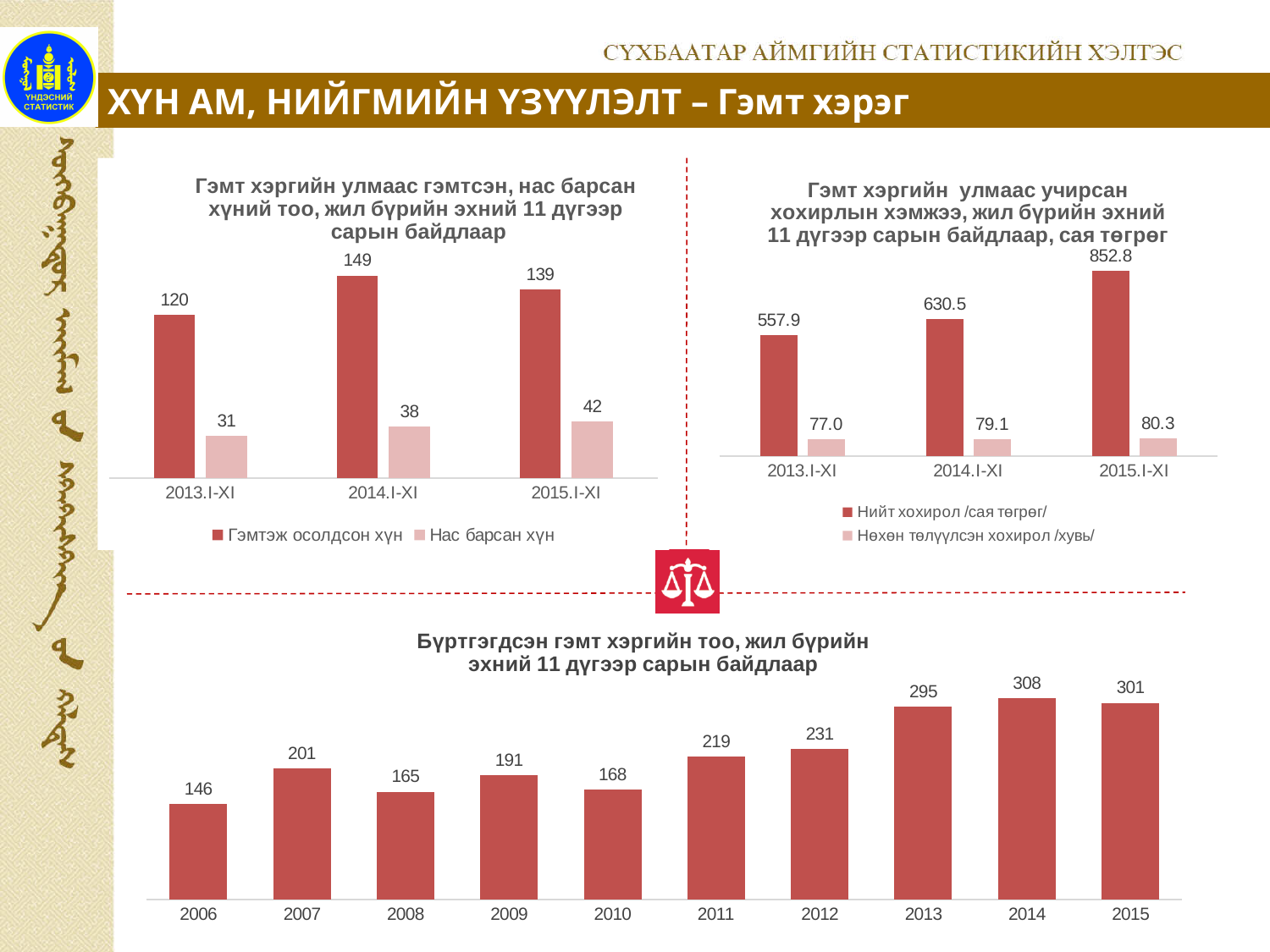
In the top-right chart (Гэмт хэргийн улмаас учирсан хохирлын хэмжээ), does the value for Нийт хохирол rise or fall from 2013.I-XI to 2015.I-XI? rise What kind of chart is the bottom chart (Бүртгэгдсэн гэмт хэргийн тоо)? bar chart In the bottom chart (Бүртгэгдсэн гэмт хэргийн тоо), what is the difference between the values for 2015 and 2006? 155 In the bottom chart (Бүртгэгдсэн гэмт хэргийн тоо), how many years are shown on the x axis? 10 In the top-left chart (Гэмт хэргийн улмаас гэмтсэн, нас барсан хүний тоо), how many series does the legend list? 2 In the bottom chart (Бүртгэгдсэн гэмт хэргийн тоо), which year has the highest value? 2014 In the bottom chart (Бүртгэгдсэн гэмт хэргийн тоо), which year has the lowest value? 2006 In the top-left chart (Гэмт хэргийн улмаас гэмтсэн, нас барсан хүний тоо), what is the value for Нас барсан хүн in 2015.I-XI? 42 In the top-right chart (Гэмт хэргийн улмаас учирсан хохирлын хэмжээ), what is the value for Нийт хохирол in 2015.I-XI? 852.8 In the top-left chart (Гэмт хэргийн улмаас гэмтсэн, нас барсан хүний тоо), what is the value for Гэмтэж осолдсон хүн in 2014.I-XI? 149 In the bottom chart (Бүртгэгдсэн гэмт хэргийн тоо), what is the value for 2013? 295 In the top-right chart (Гэмт хэргийн улмаас учирсан хохирлын хэмжээ), what is the value for Нөхөн төлүүлсэн хохирол in 2013.I-XI? 77.0